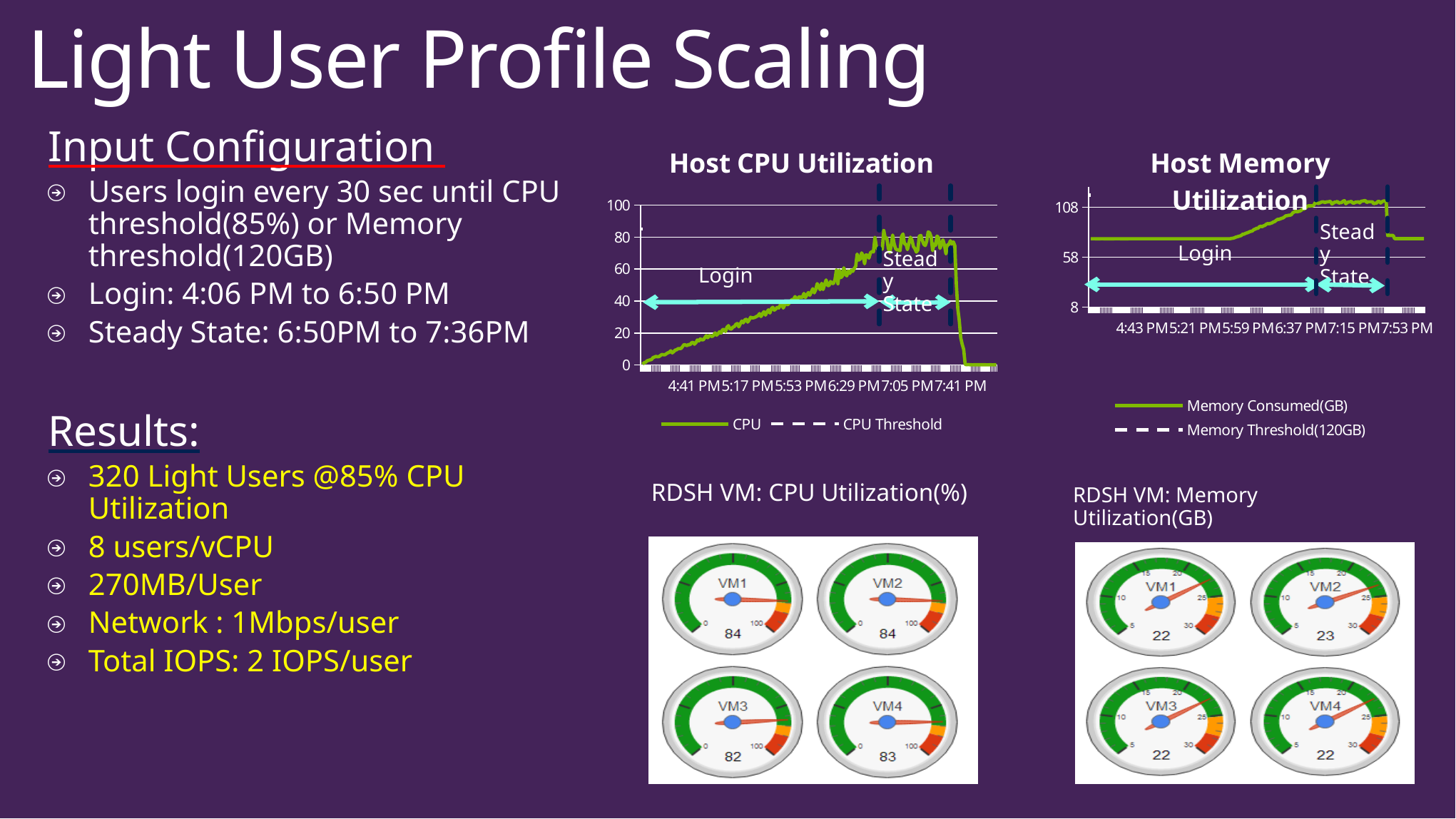
In the RDSH VM: CPU Utilization(%) gauges, what is the value shown for VM3? 82 In the Host CPU Utilization chart, is the CPU value at 6:29 PM greater or less than 40? greater In the Host CPU Utilization chart, does the CPU line rise or fall between 4:41 PM and 6:29 PM? rise What kind of chart is the Host CPU Utilization chart? line chart In the RDSH VM: Memory Utilization(GB) gauges, which VM shows the highest value? VM2 In the RDSH VM: CPU Utilization(%) gauges, what is the difference between the VM1 value and the VM3 value? 2 How many series does the legend of the Host CPU Utilization chart list? 2 In the Host CPU Utilization chart, what are the two legend entries? CPU and CPU Threshold How many series does the legend of the Host Memory Utilization chart list? 2 In the Host CPU Utilization chart, is the CPU value at 5:17 PM greater or less than 40? less In the Host Memory Utilization chart, is the Memory Consumed value at 4:43 PM greater or less than 58? greater In the RDSH VM: CPU Utilization(%) gauges, which VM shows the lowest value? VM3